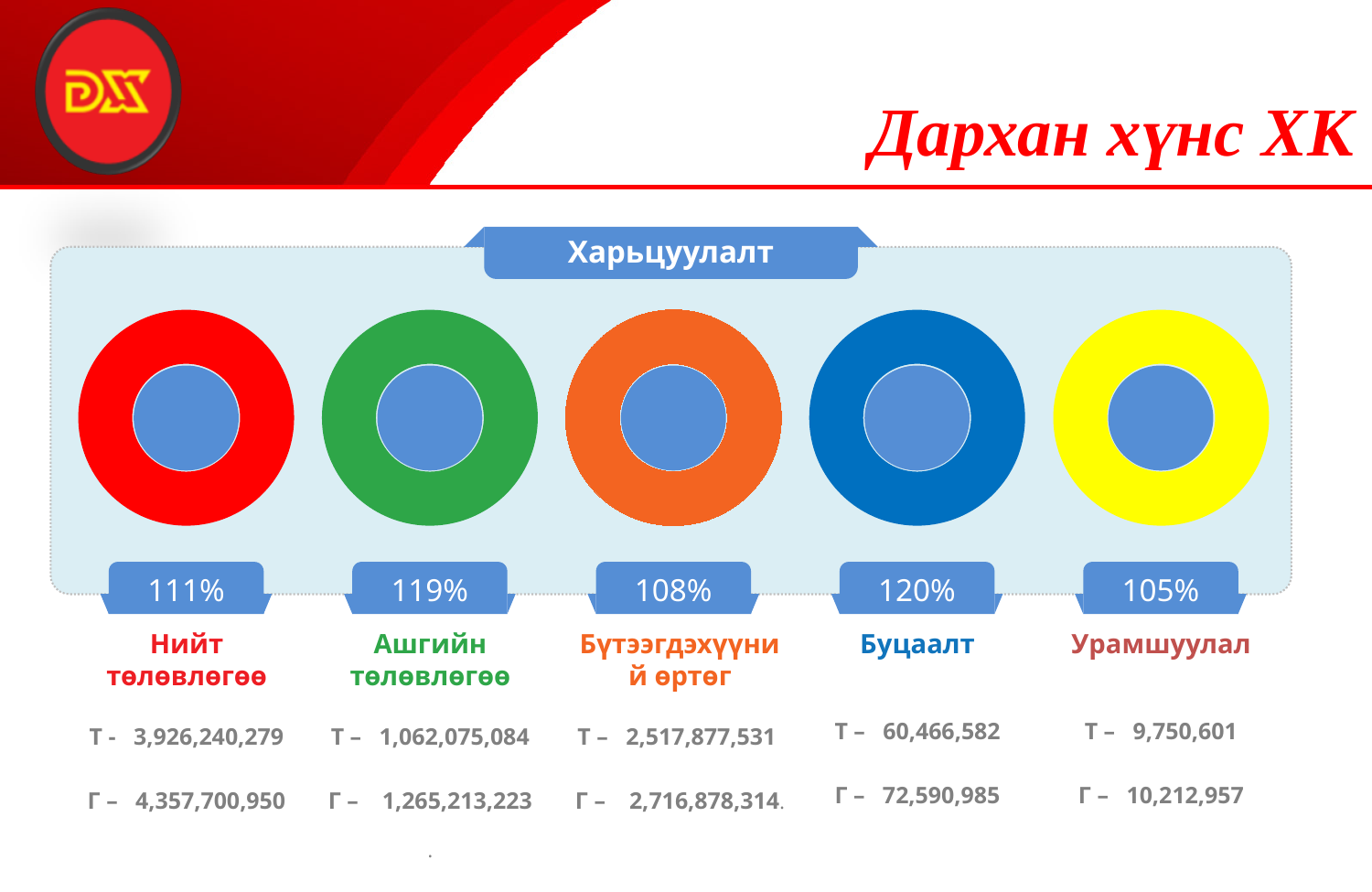
How many categories are shown in the comparison? 5 What percentage is shown for Урамшуулал? 105% What is the Г value listed under Буцаалт? 72,590,985 What is the title shown above the comparison panel? Харьцуулалт What is the Г value listed under Бүтээгдэхүүний өртөг? 2,716,878,314 Which category has the highest percentage? Буцаалт What is the Т value listed under Ашгийн төлөвлөгөө? 1,062,075,084 Which has a higher percentage, Нийт төлөвлөгөө or Ашгийн төлөвлөгөө? Ашгийн төлөвлөгөө Which category has the lowest percentage? Урамшуулал What percentage is shown for Нийт төлөвлөгөө? 111% What percentage is shown for Буцаалт? 120% What is the difference in percentage points between Ашгийн төлөвлөгөө and Бүтээгдэхүүний өртөг? 11